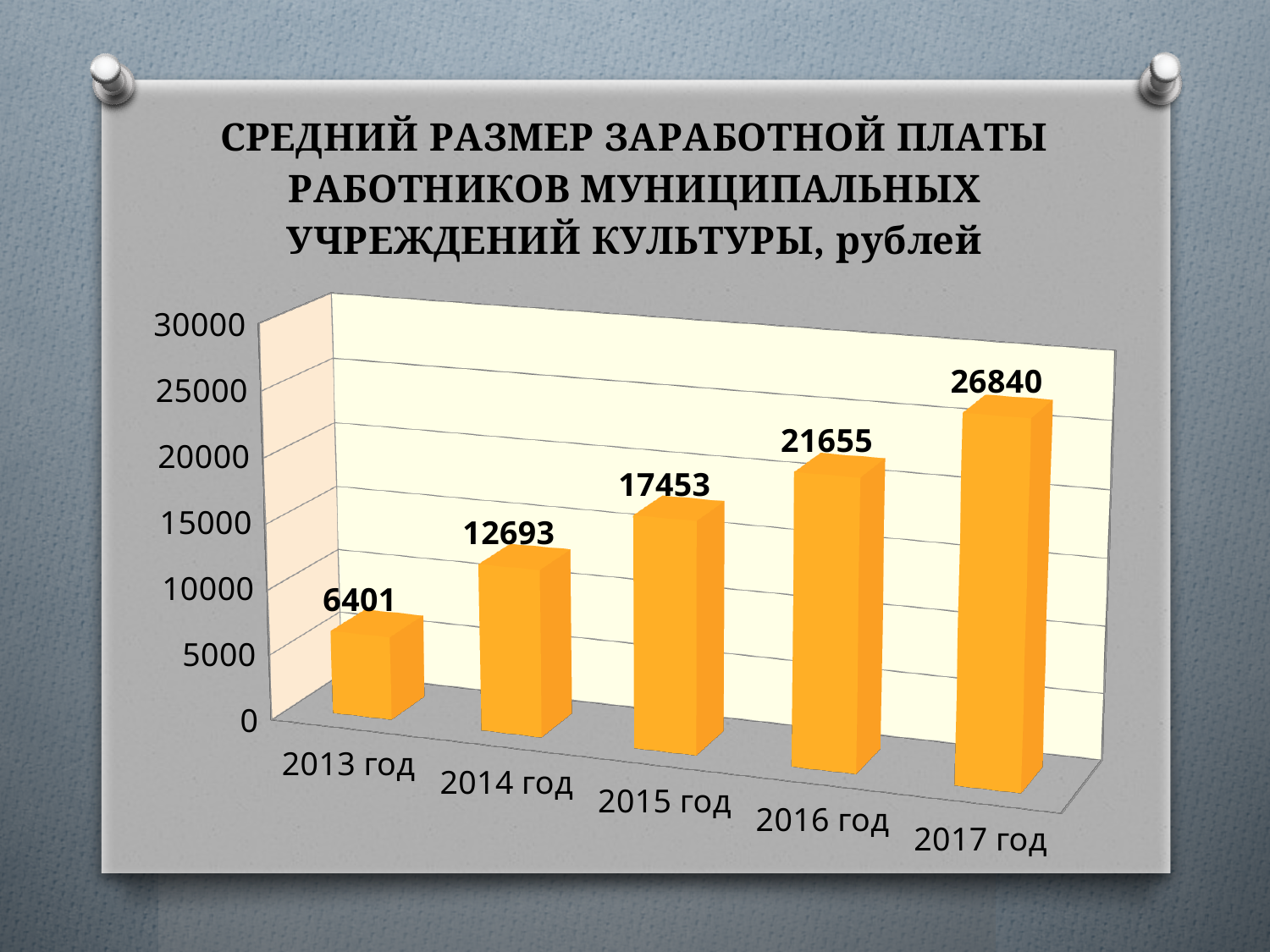
Which year has the highest value? 2017 год What is the average salary value shown for 2013 год? 6401 Which is larger, the value for 2014 год or the value for 2015 год? 2015 год Do the values rise or fall from 2013 год to 2017 год? rise How many years are shown on the chart? 5 What is the difference between the values for 2014 год and 2013 год? 6292 What is the difference between the values for 2017 год and 2016 год? 5185 What kind of chart is shown on the slide? bar chart What is the value shown for 2017 год? 26840 Is the value for 2016 год greater or less than 20000? greater Which year has the lowest value? 2013 год What is the value shown for 2015 год? 17453